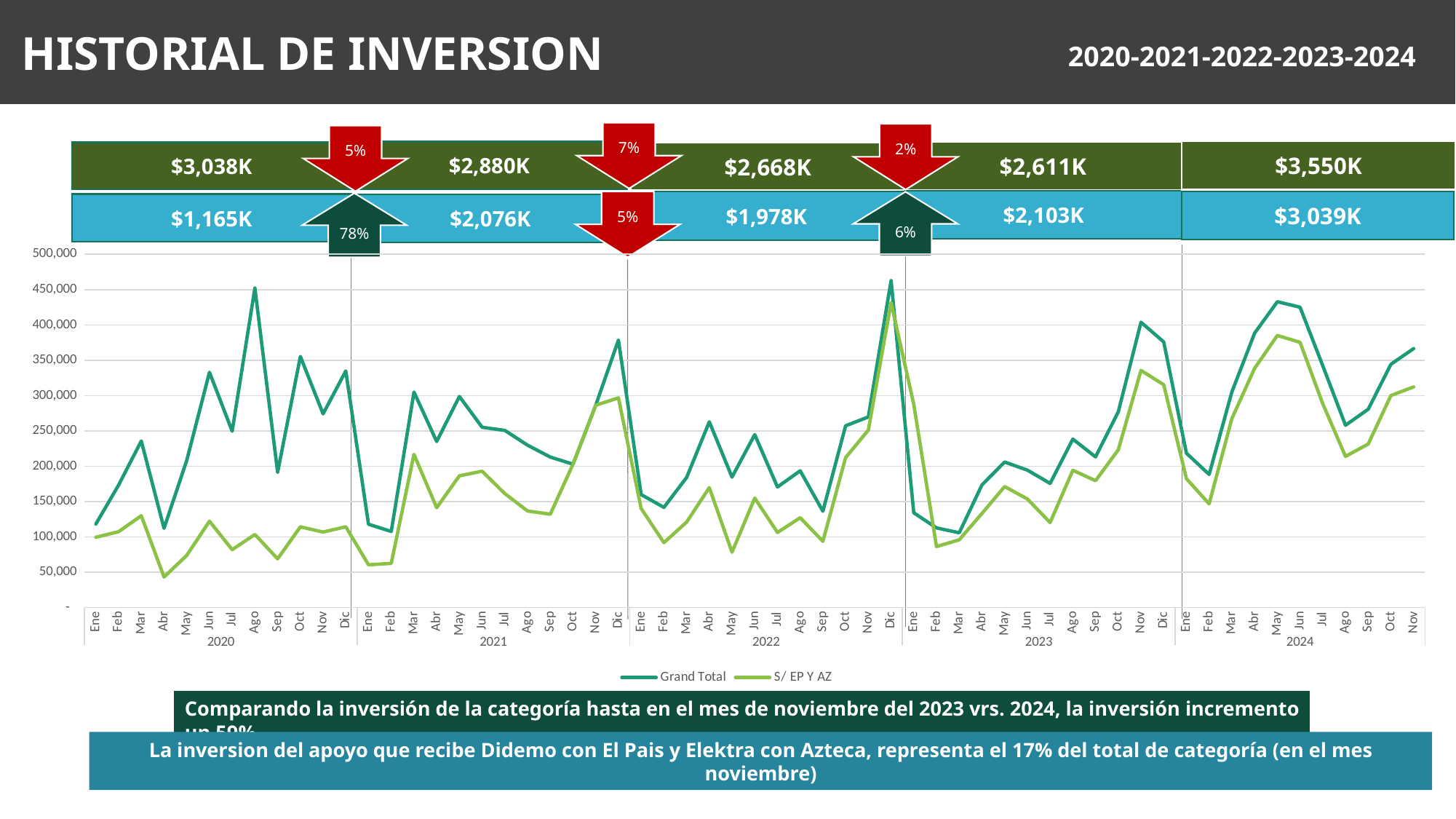
Is the S/ EP Y AZ value for Feb 2023 greater or less than 100,000? less What kind of chart is shown on the slide? line chart In Ene 2020, which series has the larger value, Grand Total or S/ EP Y AZ? Grand Total How many series does the chart legend list? 2 What annual value is shown in the blue banner above the chart for 2020? $1,165K Does the Grand Total line rise or fall from Ene 2024 to May 2024? rise Is the Grand Total value for Dic 2022 greater or less than 400,000? greater What are the two series named in the chart legend? Grand Total and S/ EP Y AZ What annual value is shown in the green banner above the chart for 2024? $3,550K Is the Grand Total value for Ago 2020 greater or less than 400,000? greater How many years are shown along the x axis of the chart? 5